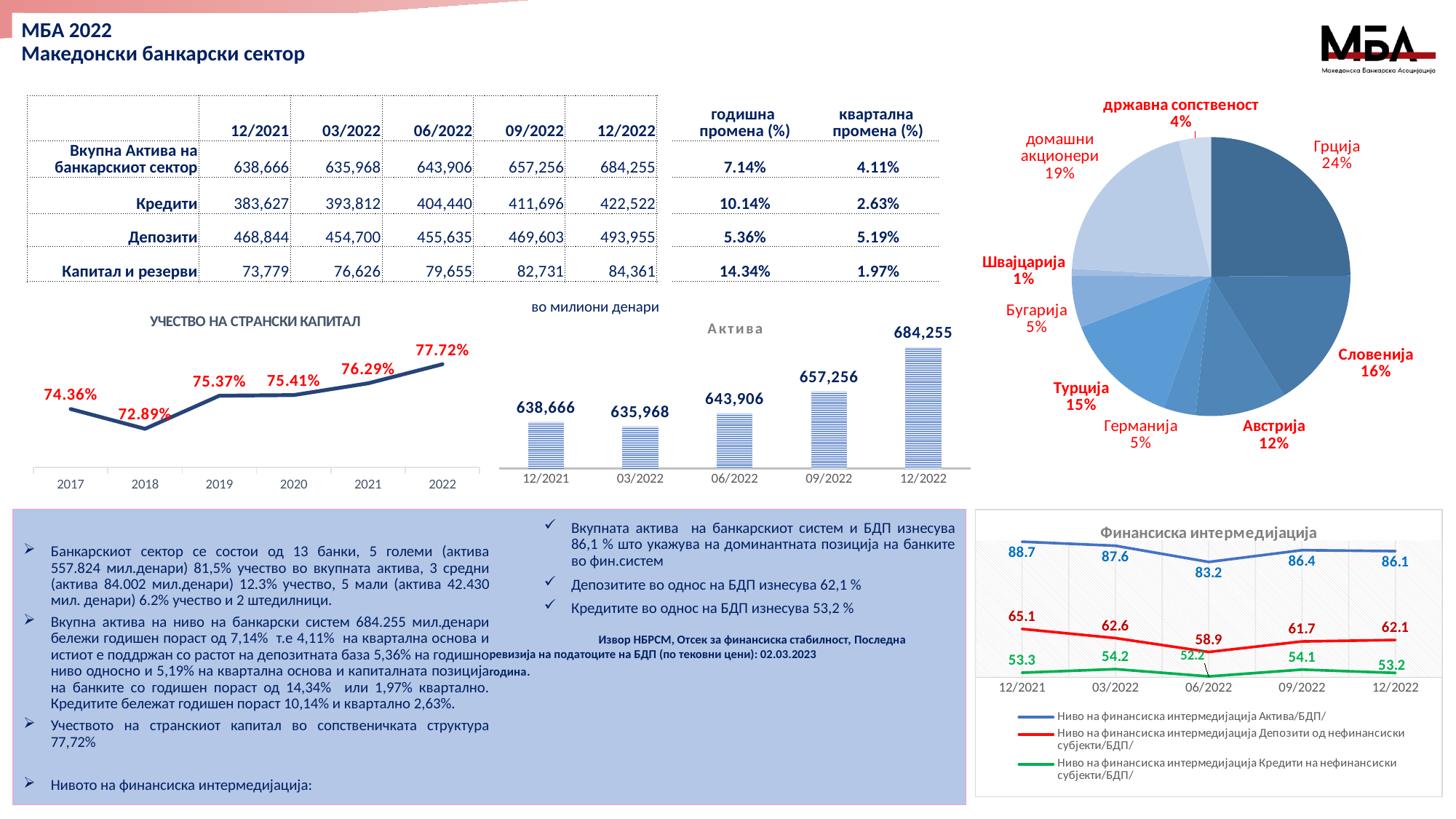
In the pie chart of ownership structure, what share does Грција hold? 24% In the 'Финансиска интермедијација' chart, what is the value of the red series (Депозити од нефинансиски субјекти/БДП) at 06/2022? 58.9 In the 'УЧЕСТВО НА СТРАНСКИ КАПИТАЛ' line chart, what is the value for 2022? 77.72% In the pie chart of ownership structure, which is larger, Турција or Австрија? Турција In the 'Актива' bar chart, which period has the highest value? 12/2022 In the 'УЧЕСТВО НА СТРАНСКИ КАПИТАЛ' line chart, which year has the lowest value? 2018 What kind of chart is the 'Актива' chart? Bar chart In the 'Актива' bar chart, what is the value for 09/2022? 657,256 In the 'УЧЕСТВО НА СТРАНСКИ КАПИТАЛ' line chart, how many years are plotted? 6 In the 'Актива' bar chart, what is the difference between the values for 12/2022 and 12/2021? 45,589 In the 'Финансиска интермедијација' chart, how many series does the legend list? 3 In the pie chart of ownership structure, which slice is the smallest? Швајцарија